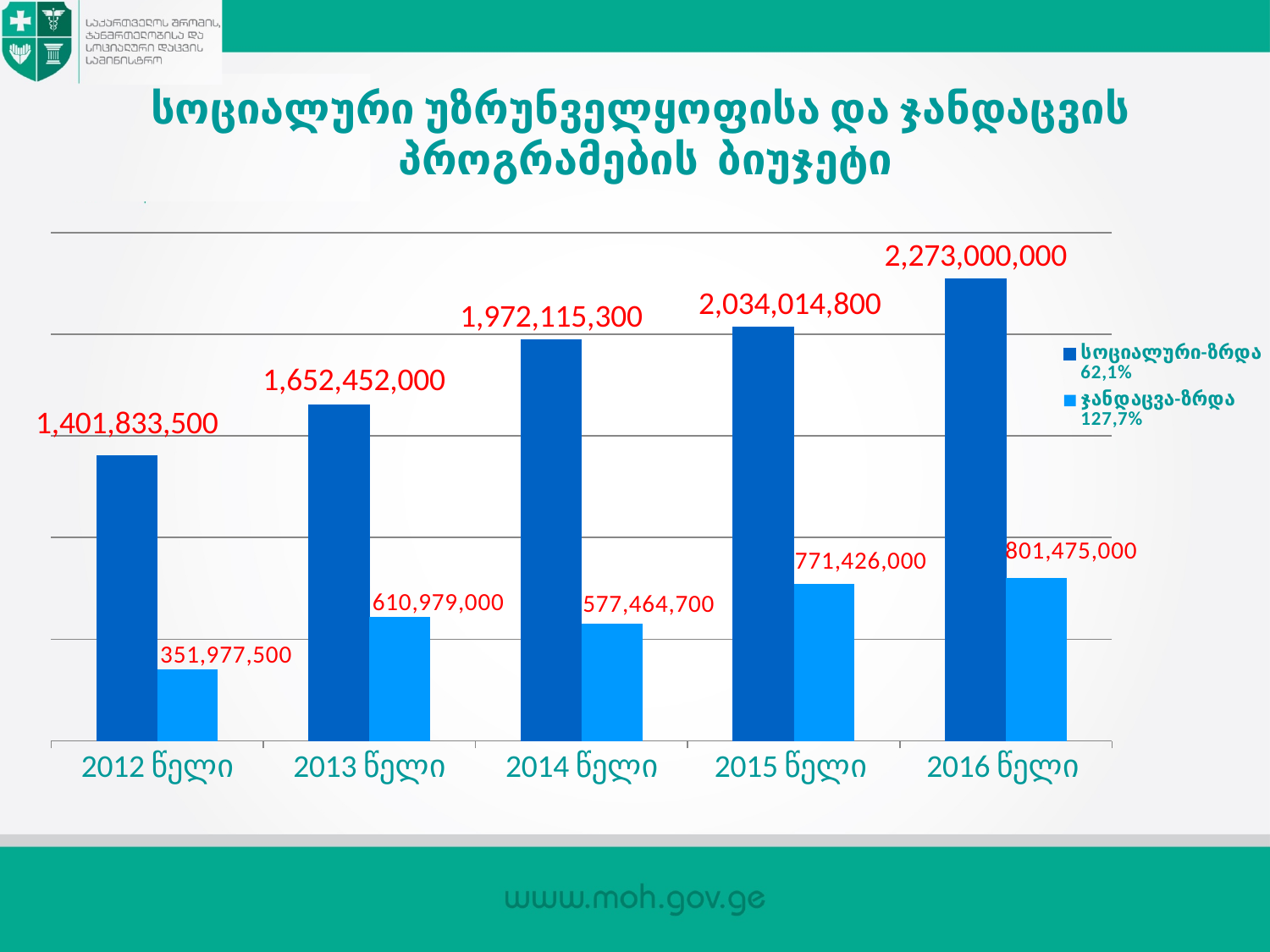
Which is larger, the ჯანდაცვა value for 2013 წელი or for 2014 წელი? 2013 წელი What kind of chart is shown on the slide? Bar chart By how much did the სოციალური value increase from 2012 წელი to 2013 წელი? 250,618,500 In which year is the ჯანდაცვა series lowest? 2012 წელი How many years are shown on the x axis? 5 What is the difference between the სოციალური and ჯანდაცვა values for 2016 წელი? 1,471,525,000 How many series does the legend list? 2 Does the სოციალური series rise or fall from 2012 წელი to 2016 წელი? Rise In which year is the სოციალური series highest? 2016 წელი What is the value of the ჯანდაცვა series for 2012 წელი? 351,977,500 What is the value of the სოციალური series for 2012 წელი? 1,401,833,500 What is the value of the ჯანდაცვა series for 2015 წელი? 771,426,000